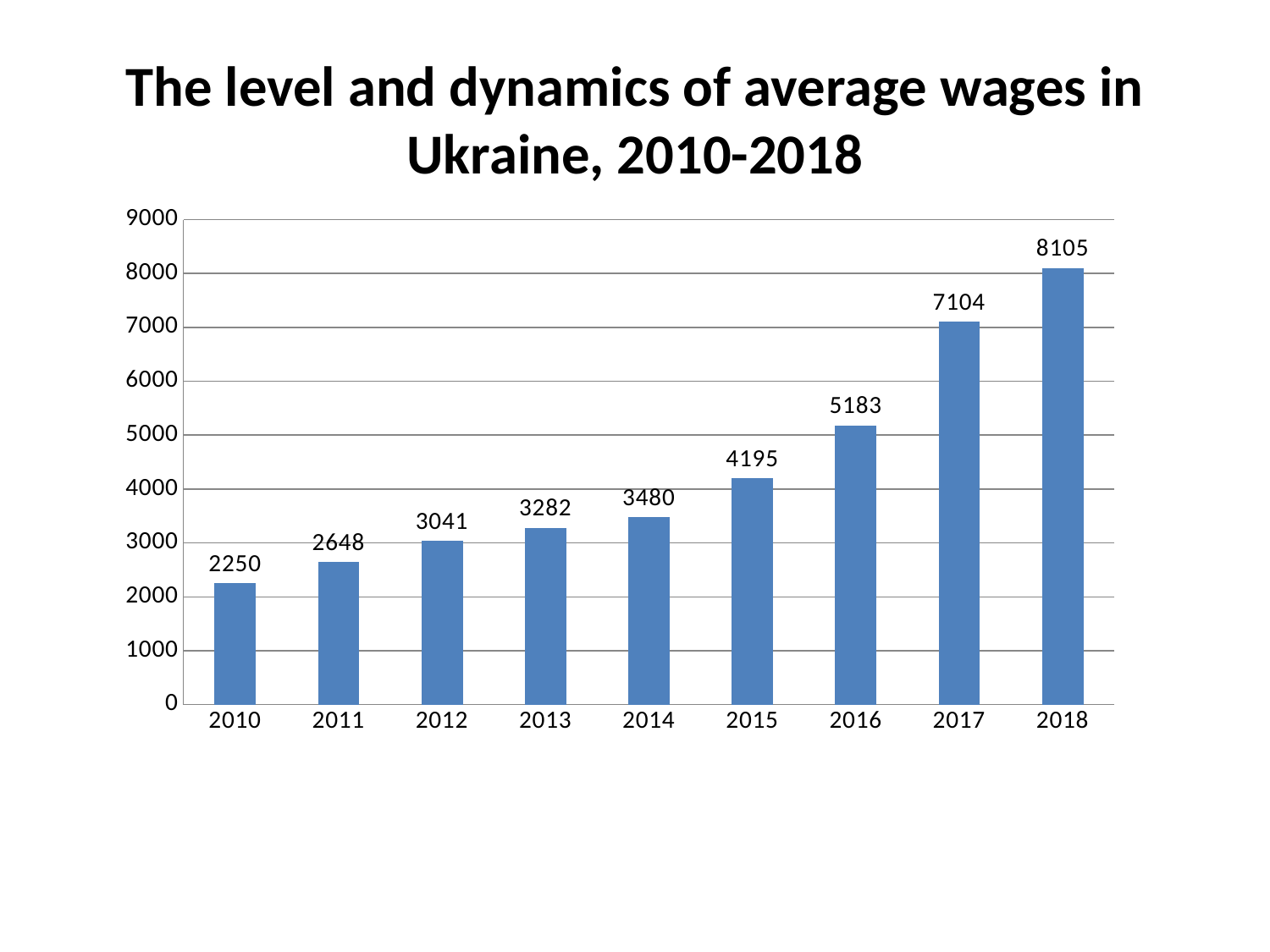
How many years are shown on the x axis? 9 Which is larger, the value for 2013 or the value for 2012? 2013 Which year has the lowest average wage? 2010 What is the value shown for 2011? 2648 What is the difference between the values for 2016 and 2015? 988 Do the values rise or fall from 2010 to 2018? rise What is the difference between the values for 2018 and 2017? 1001 Which year has the highest average wage? 2018 What is the title of the chart on the slide? The level and dynamics of average wages in Ukraine, 2010-2018 What kind of chart is shown on the slide? bar chart What is the average wage value shown for 2014? 3480 Is the value for 2016 greater or less than 5000? greater